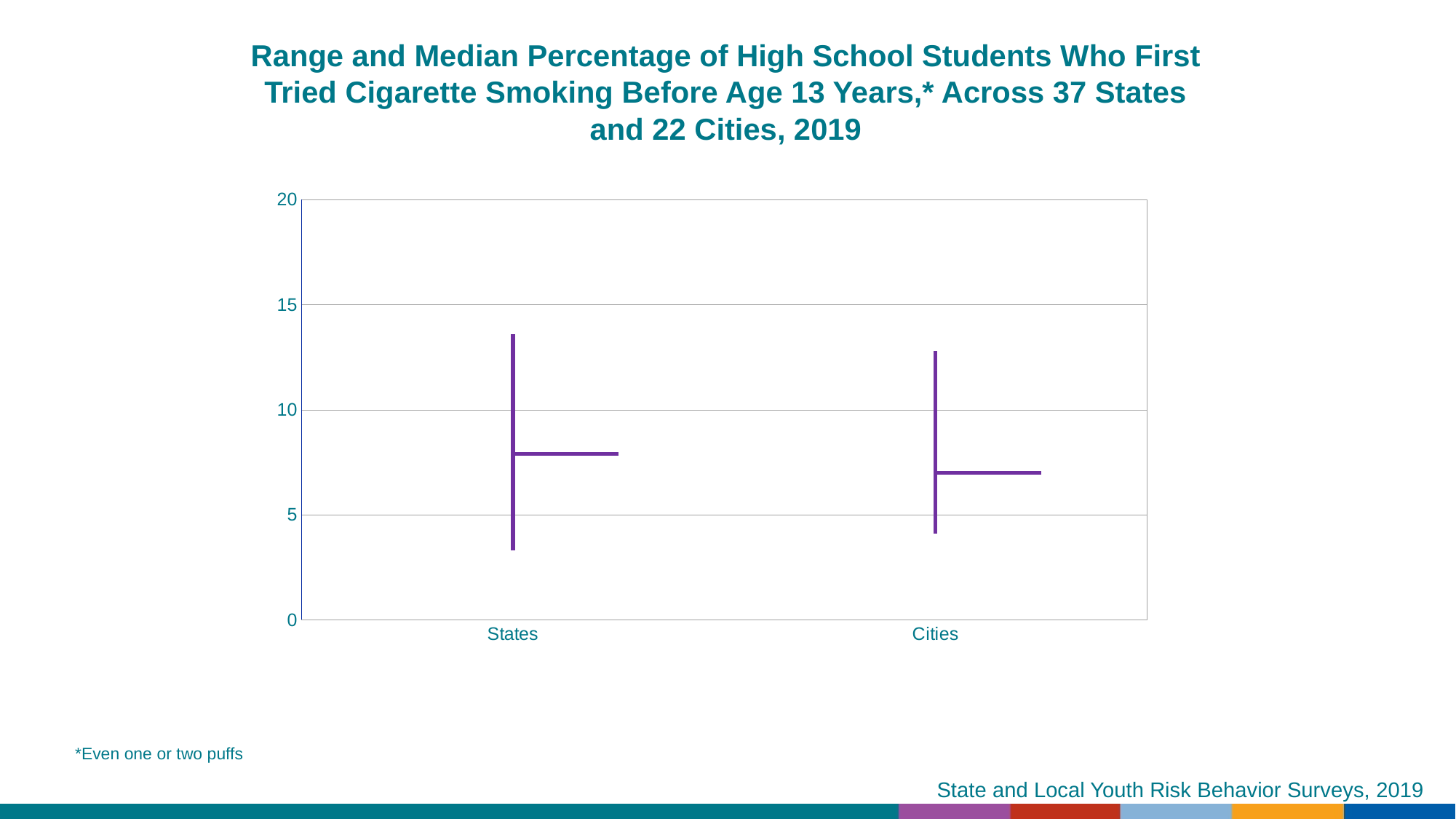
What is the highest value shown on the y axis? 20 Is the top of the range for States greater or less than 10? greater Which category has the higher median value, States or Cities? States How many categories are shown on the x axis of the chart? 2 Is the bottom of the range for States greater or less than 5? less According to the title, how many states and how many cities are included in the chart? 37 states and 22 cities Which category has the lower bottom of its range, States or Cities? States Is the median value for States greater or less than 10? less What are the two categories shown on the x axis? States and Cities